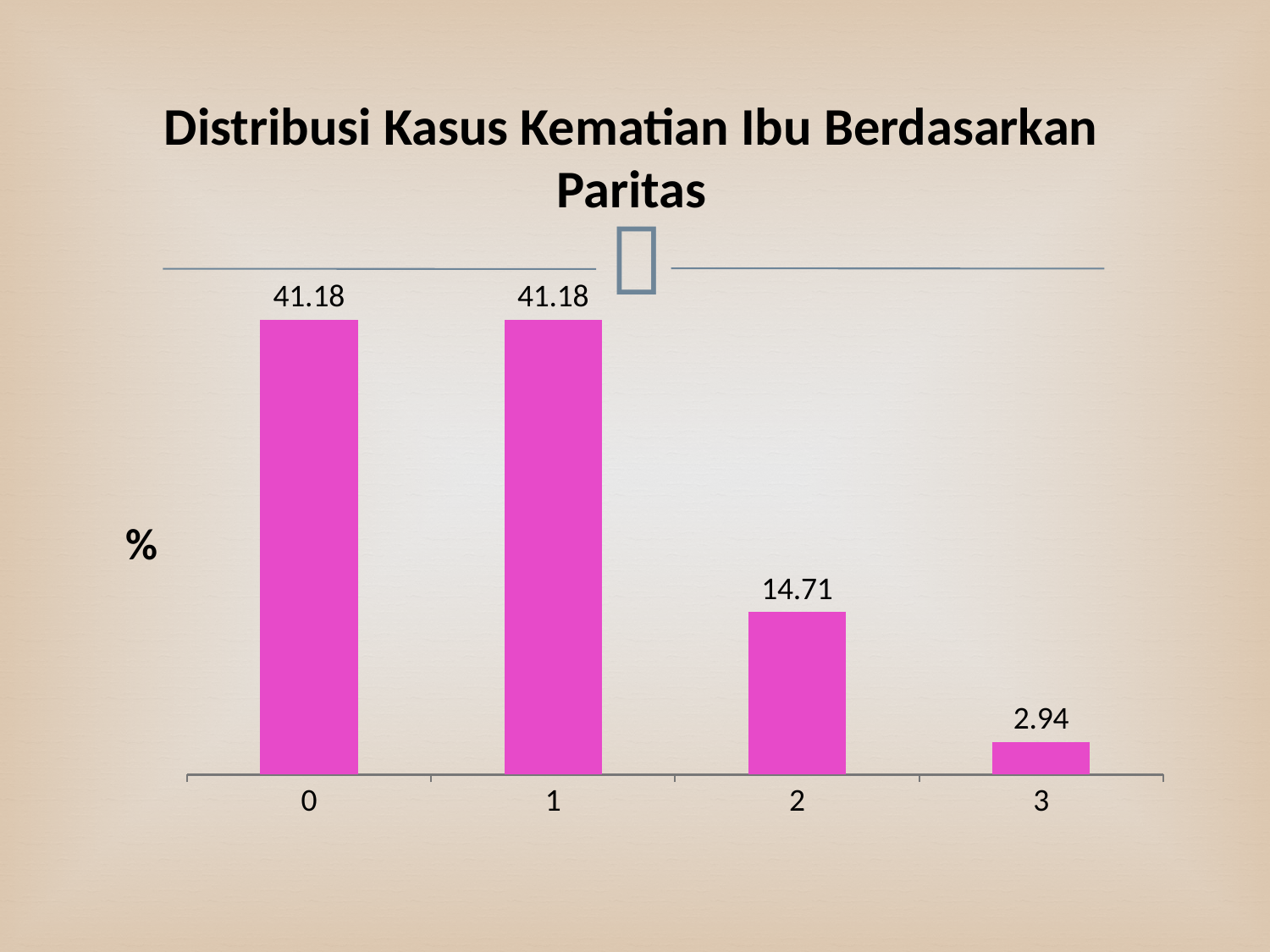
Which parity category has the lowest value? 3 How many parity categories are shown on the x axis? 4 Do the values rise or fall from parity 1 to parity 3 along the x axis? fall What is the value for parity 0? 41.18 What is the value for parity 2? 14.71 What is the difference between the values for parity 1 and parity 2? 26.47 What is the difference between the values for parity 2 and parity 3? 11.77 What is the value for parity 3? 2.94 Which is larger, the value for parity 2 or the value for parity 3? parity 2 What kind of chart is shown on the slide? bar chart Which is larger, the value for parity 0 or the value for parity 2? parity 0 What is the title of the chart? Distribusi Kasus Kematian Ibu Berdasarkan Paritas